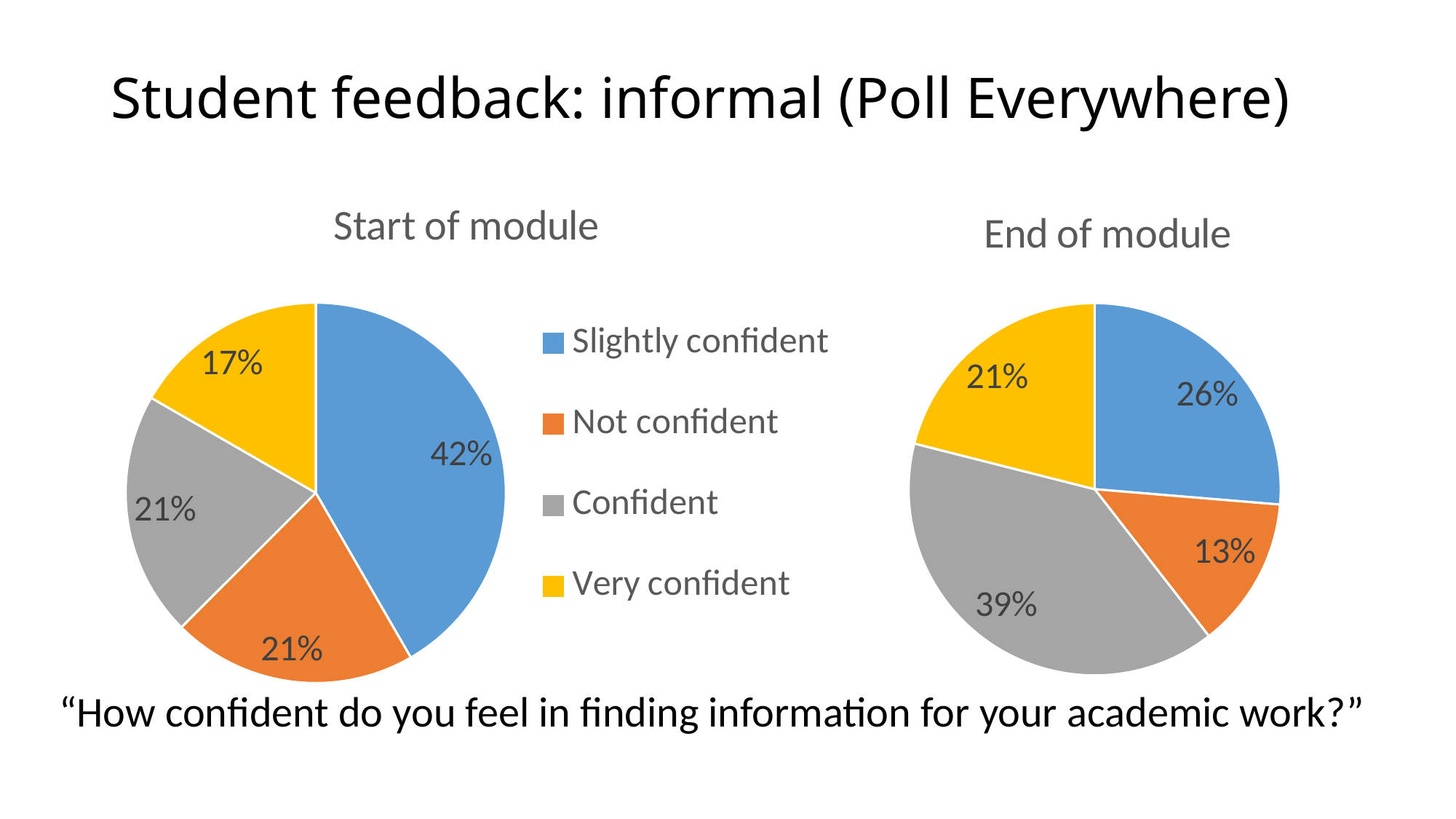
In the 'End of module' chart, what share is labelled for Confident? 39% What kind of chart is the 'Start of module' chart? Pie chart In the 'End of module' chart, which is larger: the Slightly confident slice or the Very confident slice? Slightly confident Which colour represents Confident in the legend? Grey In the 'End of module' chart, what share is labelled for Not confident? 13% What is the difference between the Slightly confident share in the 'Start of module' chart and in the 'End of module' chart? 16% In the 'Start of module' chart, what share is labelled for Very confident? 17% In the 'End of module' chart, which category has the smallest slice? Not confident In the 'Start of module' chart, which category has the largest slice? Slightly confident In the 'End of module' chart, which category has the largest slice? Confident How many categories does the legend list for the pie charts? 4 In the 'Start of module' chart, what share is labelled for Slightly confident? 42%